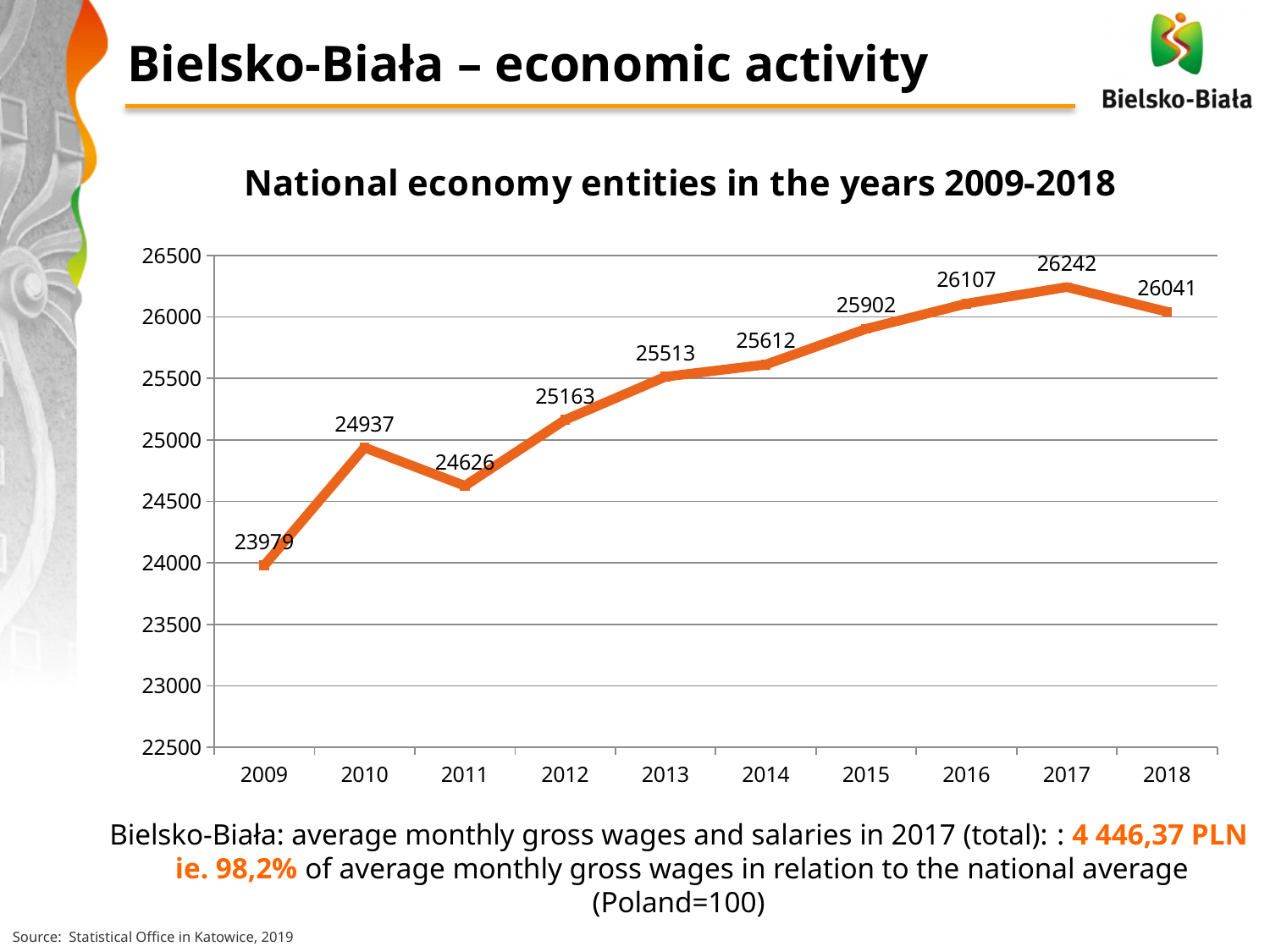
What is the value for 2017 in the chart? 26242 What is the difference between the values for 2018 and 2017? 201 What is the title of the chart? National economy entities in the years 2009-2018 What is the difference between the values for 2010 and 2009? 958 Which year has the highest value in the chart? 2017 What is the value for 2013 in the chart? 25513 Which year has the lowest value in the chart? 2009 How many years are plotted in the chart? 10 Which year has the larger value, 2010 or 2011? 2010 What is the value for 2009 in the chart? 23979 Is the value for 2014 greater or less than 26000? less What kind of chart is shown on the slide? line chart